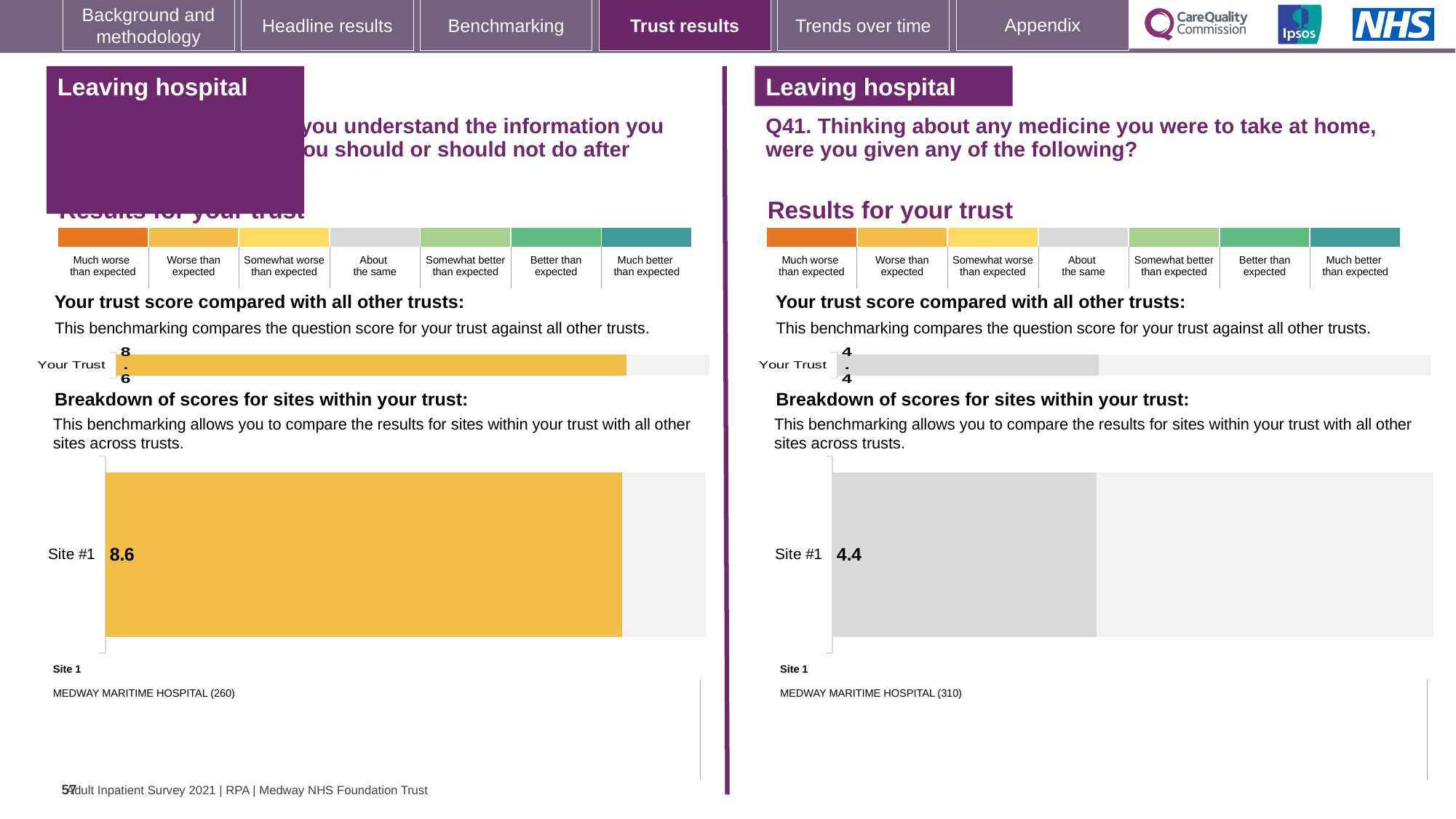
Which is larger: the Your Trust score on the left half of the slide or the Your Trust score on the right half (Q41)? Left half (8.6) What type of chart is used to show the Your Trust score on each half of the slide? Bar chart Which site is listed as Site 1 in the left-hand site breakdown? MEDWAY MARITIME HOSPITAL (260) What is the difference between the Site #1 score in the left-hand chart and the Site #1 score in the right-hand chart (Q41)? 4.2 In the left-hand site breakdown chart, what is the score for Site #1? 8.6 According to the colour key, which benchmark category does the grey colour of the Q41 Your Trust bar represent? About the same In the right-hand site breakdown chart (Q41), what is the score for Site #1? 4.4 How many sites are shown in the site breakdown chart on the right half of the slide (Q41)? 1 On the right half of the slide (Q41), what is the score shown for Your Trust? 4.4 On the left half of the slide, what is the score shown for Your Trust? 8.6